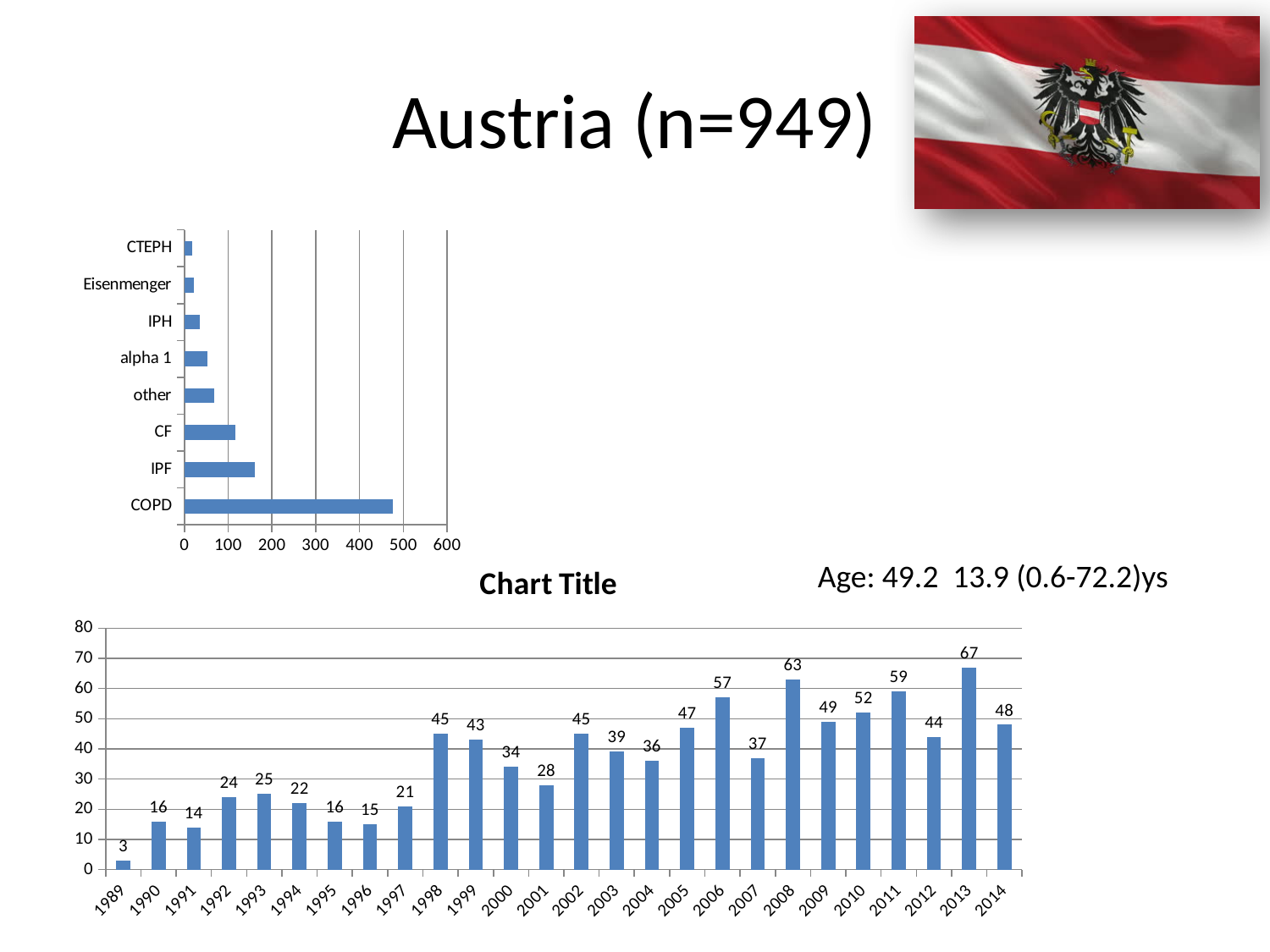
How many years are shown on the x axis of the bottom chart titled 'Chart Title'? 26 How many categories are shown in the top-left bar chart? 8 In the bottom chart titled 'Chart Title', which year has the lowest value? 1989 In the top-left bar chart, which is larger, CF or other? CF In the top-left bar chart, which category has the highest value? COPD In the bottom chart titled 'Chart Title', which year has the highest value? 2013 In the top-left bar chart, is the value for IPF greater or less than 200? less In the top-left bar chart, is the value for COPD greater or less than 400? greater What kind of chart is the top-left chart? bar chart In the bottom chart titled 'Chart Title', what is the value for 1995? 16 In the bottom chart titled 'Chart Title', what is the difference between the values for 2013 and 2012? 23 In the bottom chart titled 'Chart Title', what is the value for 2008? 63